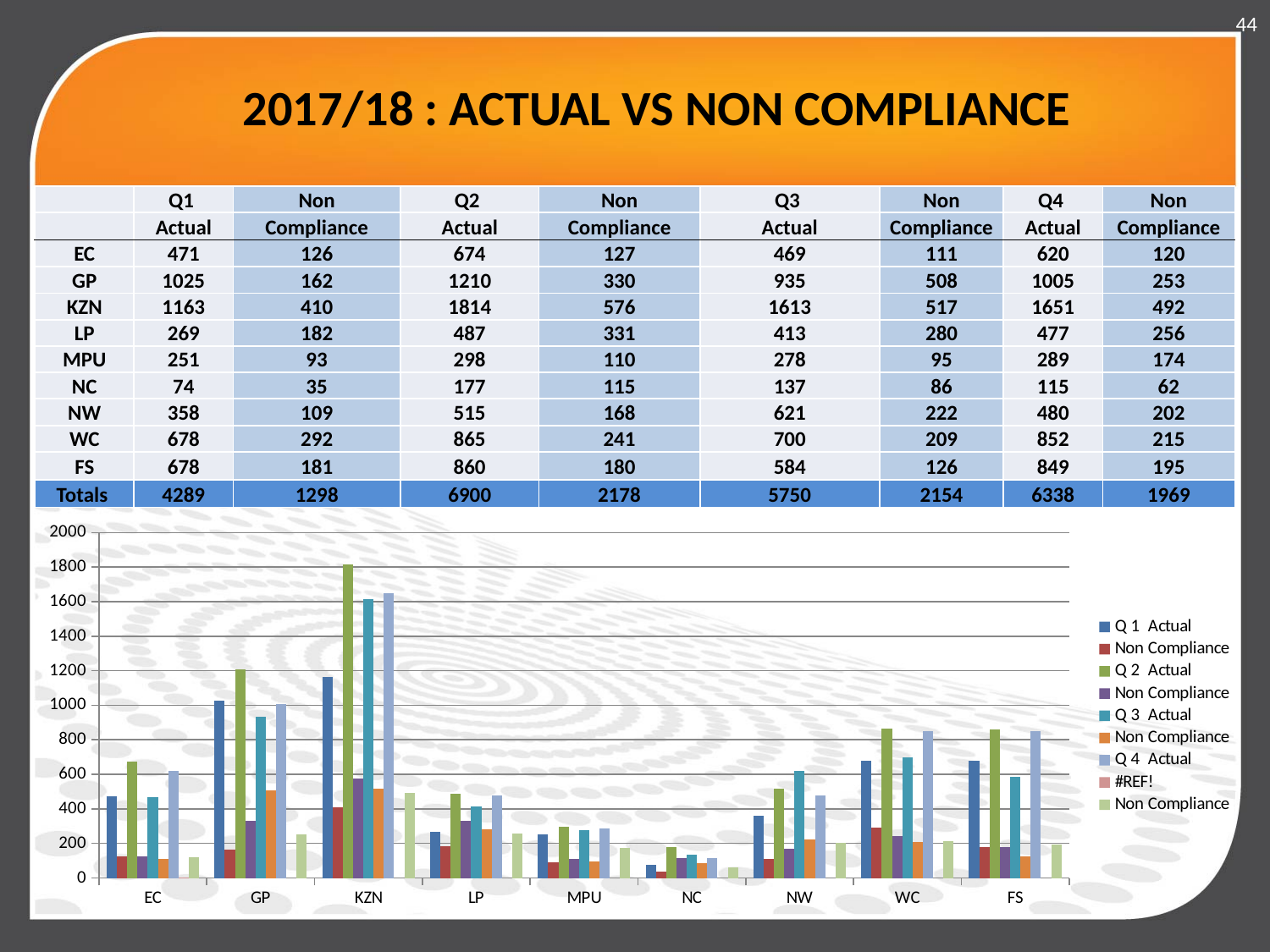
What kind of chart is shown at the bottom of the slide? Bar chart What is the Q2 Actual value for GP? 1210 Which province has the lowest Q1 Actual value? NC Which province has the tallest bar in the chart? KZN How many entries does the chart's legend list? 9 Is the Q 1 Actual value for NC greater or less than 200? less What is the difference between the Q1 Actual values for KZN and GP? 138 Which legend entry in the chart shows an error reference instead of a series name? #REF! How many provinces (categories) are shown along the x axis of the chart? 9 Which province has the larger Q3 Actual value, NW or WC? WC Is the Q 4 Actual value for WC greater or less than 800? greater Is the Q 2 Actual value for KZN greater or less than 1600? greater